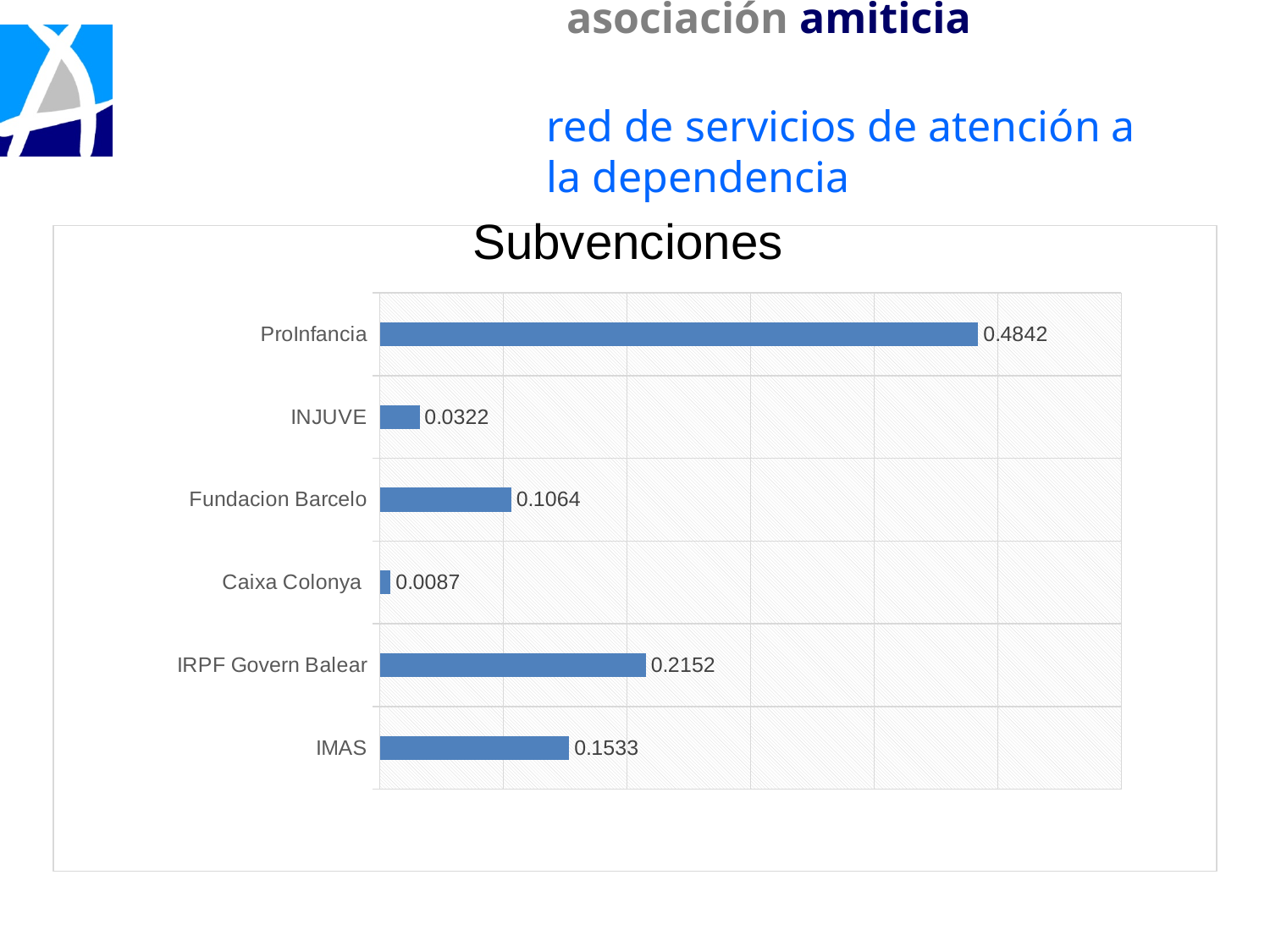
What is the value for Caixa Colonya? 0.0087 What is the title of the chart? Subvenciones What is the difference between the values for IMAS and Fundacion Barcelo? 0.0469 How many categories are shown in the chart? 6 What is the value for ProInfancia? 0.4842 What is the difference between the values for ProInfancia and IRPF Govern Balear? 0.2690 Which category has the lowest value? Caixa Colonya Which category has the highest value? ProInfancia What kind of chart is shown? Bar chart Which is larger, the value for INJUVE or the value for Fundacion Barcelo? Fundacion Barcelo What is the value for IRPF Govern Balear? 0.2152 What is the value for IMAS? 0.1533